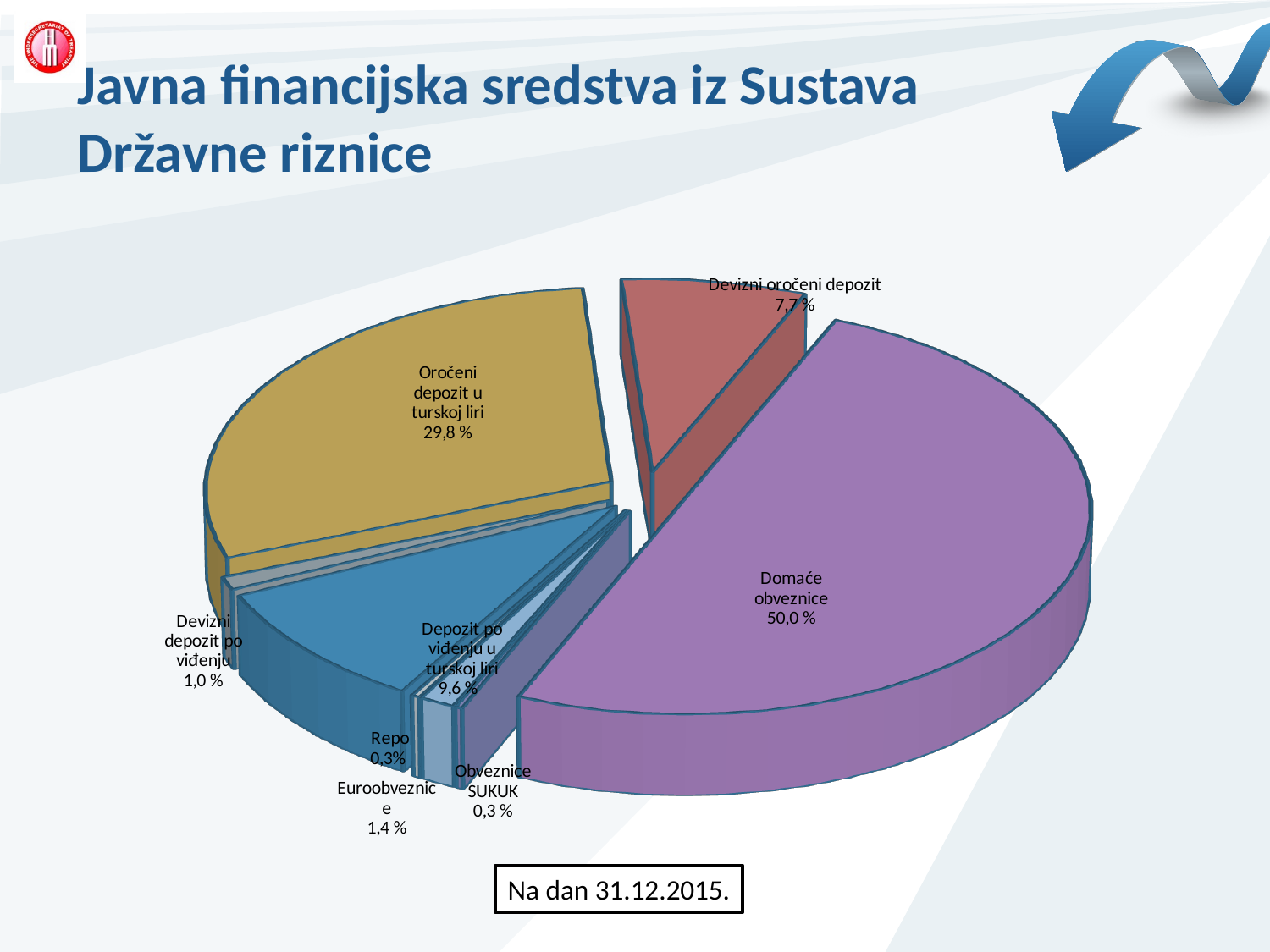
What kind of chart is shown on the slide? pie chart Which is larger, the share of Devizni oročeni depozit or the share of Depozit po viđenju u turskoj liri? Depozit po viđenju u turskoj liri Which category has the largest slice of the pie? Domaće obveznice What is the value shown for Euroobveznice? 1,4 % How many slices does the pie chart have? 8 What is the value shown for Depozit po viđenju u turskoj liri? 9,6 % What share of the pie does Domaće obveznice hold? 50,0 % What is the value shown for Devizni oročeni depozit? 7,7 % What is the value shown for Devizni depozit po viđenju? 1,0 % What is the difference between the shares of Domaće obveznice and Oročeni depozit u turskoj liri? 20,2 % What date is given in the box below the chart? 31.12.2015. What is the value shown for Oročeni depozit u turskoj liri? 29,8 %